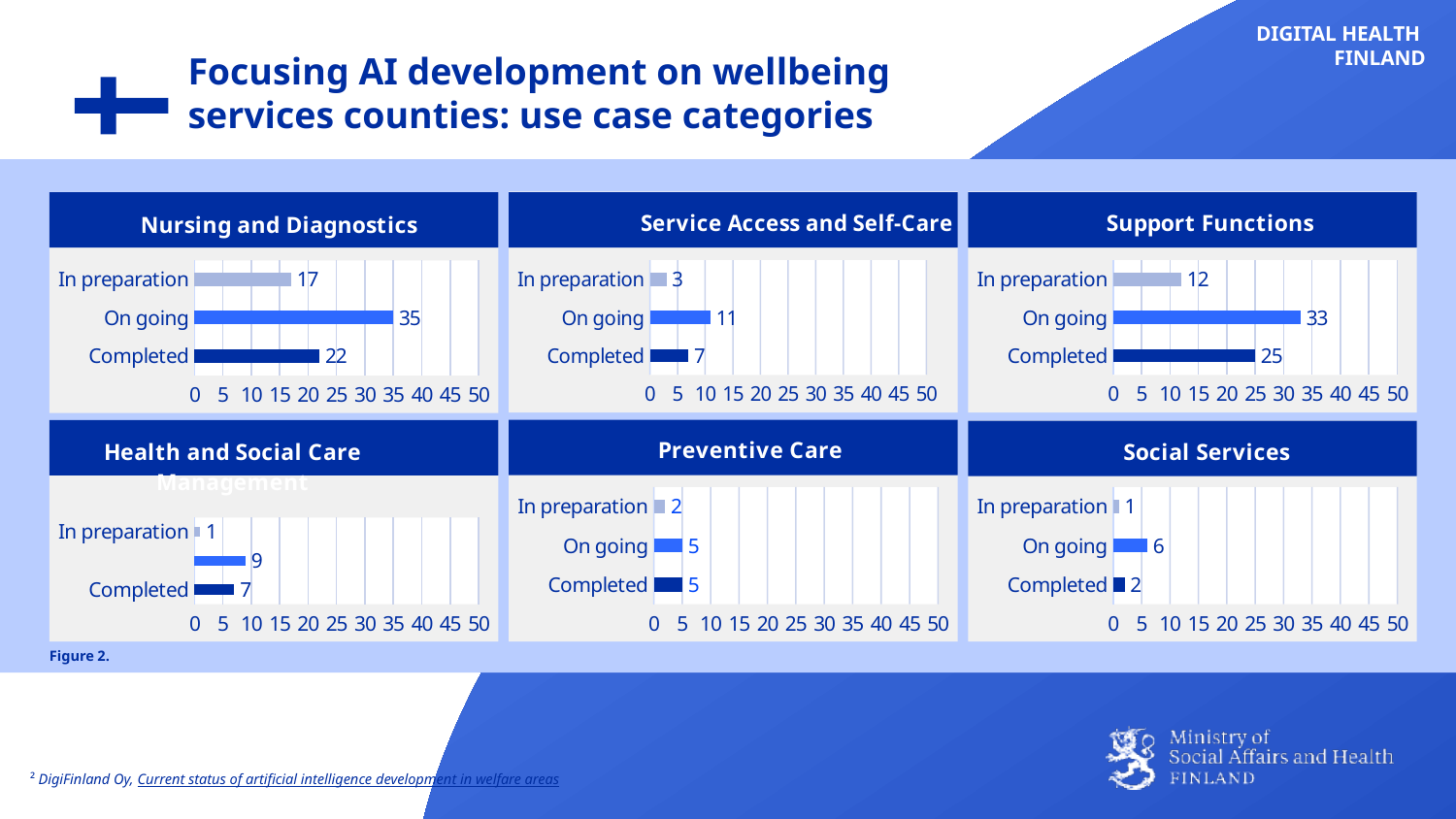
In the Nursing and Diagnostics chart, which category has the lowest value? In preparation In the Service Access and Self-Care chart, what is the value for Completed? 7 In the Support Functions chart, what is the value for In preparation? 12 In the Support Functions chart, what is the difference between On going and In preparation? 21 In the Preventive Care chart, how many categories are shown? 3 In the Service Access and Self-Care chart, which is larger, On going or Completed? On going What type of chart is the Social Services chart? Bar chart How many charts are shown on the slide? 6 In the Social Services chart, what is the value for On going? 6 In the Nursing and Diagnostics chart, what is the difference between On going and Completed? 13 In the Nursing and Diagnostics chart, what is the value for On going? 35 In the Support Functions chart, which category has the highest value? On going